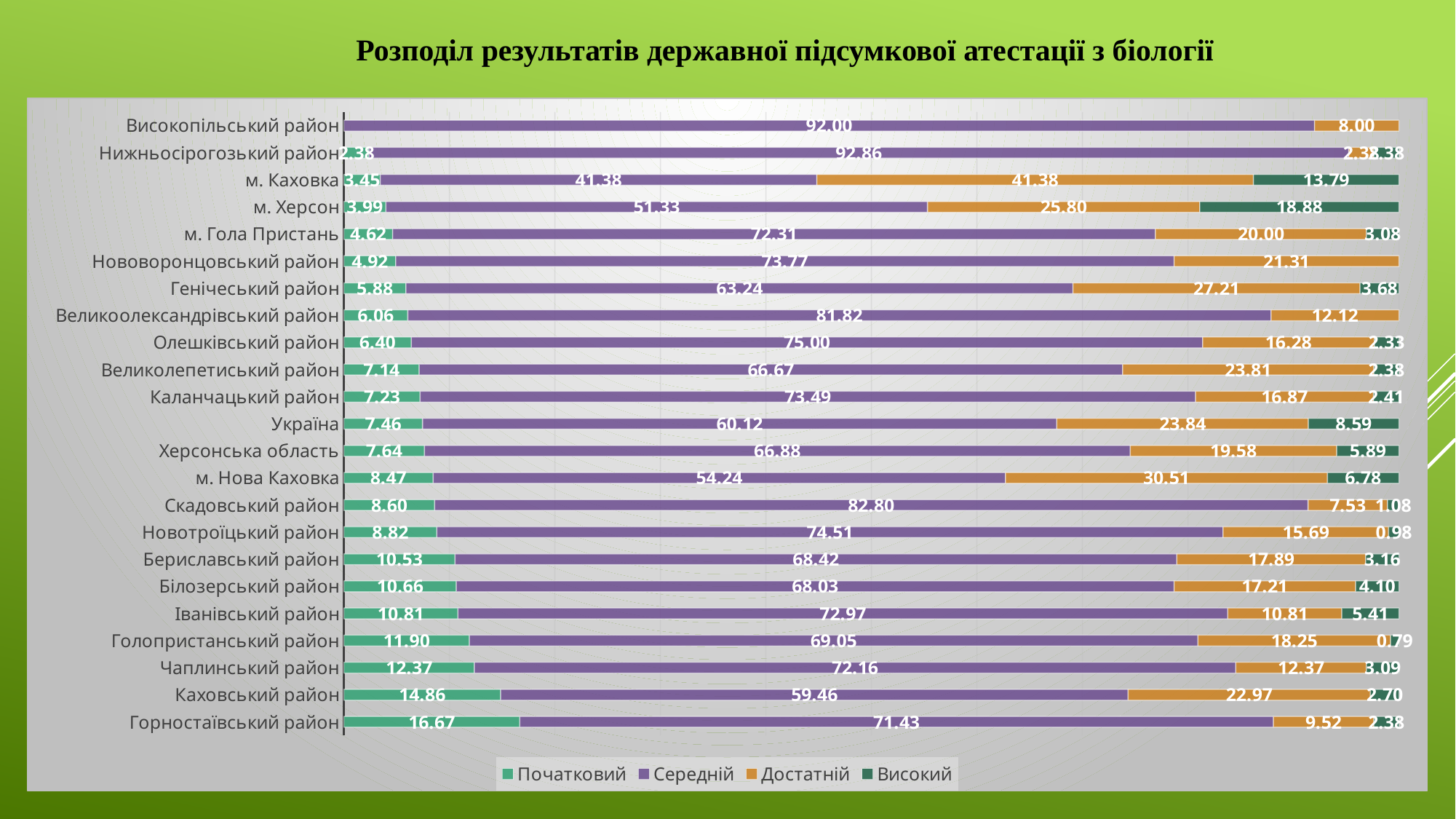
What kind of chart is shown on the slide? Stacked bar chart How many categories (regions) are plotted on the chart? 23 What is the difference between the Середній values for Херсонська область and Україна? 6.76 Which category has the highest Високий value? м. Херсон How many series does the legend list? 4 What is the title of the chart? Розподіл результатів державної підсумкової атестації з біології What is the Високий value for м. Херсон? 18.88 What is the Середній value for Високопільський район? 92.00 Which category has the highest Початковий value? Горностаївський район What is the Початковий value for Горностаївський район? 16.67 What is the Достатній value for м. Нова Каховка? 30.51 Which is larger, the Високий value for м. Каховка or for м. Херсон? м. Херсон